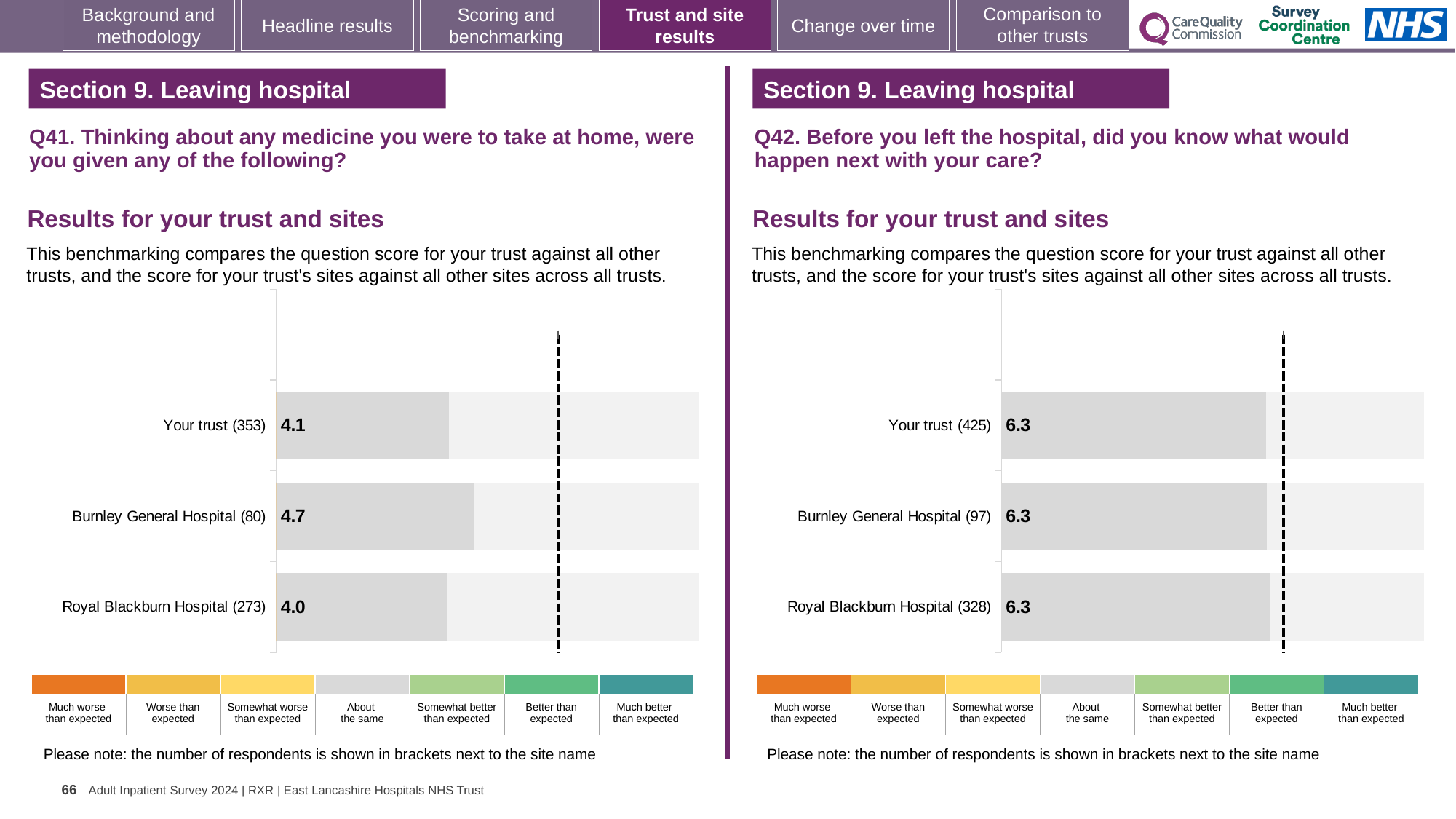
In the Q42 chart on the right, what is the score for Your trust? 6.3 What kind of chart is used in the Q41 chart on the left? Bar chart In the Q41 chart on the left, which site or trust has the lowest score? Royal Blackburn Hospital In the Q41 chart on the left, how many respondents are shown in brackets for Royal Blackburn Hospital? 273 How many bars are plotted in the Q42 chart on the right? 3 In the Q41 chart on the left, which site or trust has the highest score? Burnley General Hospital In the Q41 chart on the left, what is the score for Burnley General Hospital? 4.7 In the Q41 chart on the left, what is the difference between the scores for Burnley General Hospital and Royal Blackburn Hospital? 0.7 In the Q42 chart on the right, how many respondents are shown in brackets for Your trust? 425 In the Q42 chart on the right, what is the score for Burnley General Hospital? 6.3 In the Q41 chart on the left, what is the score for Your trust? 4.1 In the Q41 chart on the left, what is the score for Royal Blackburn Hospital? 4.0